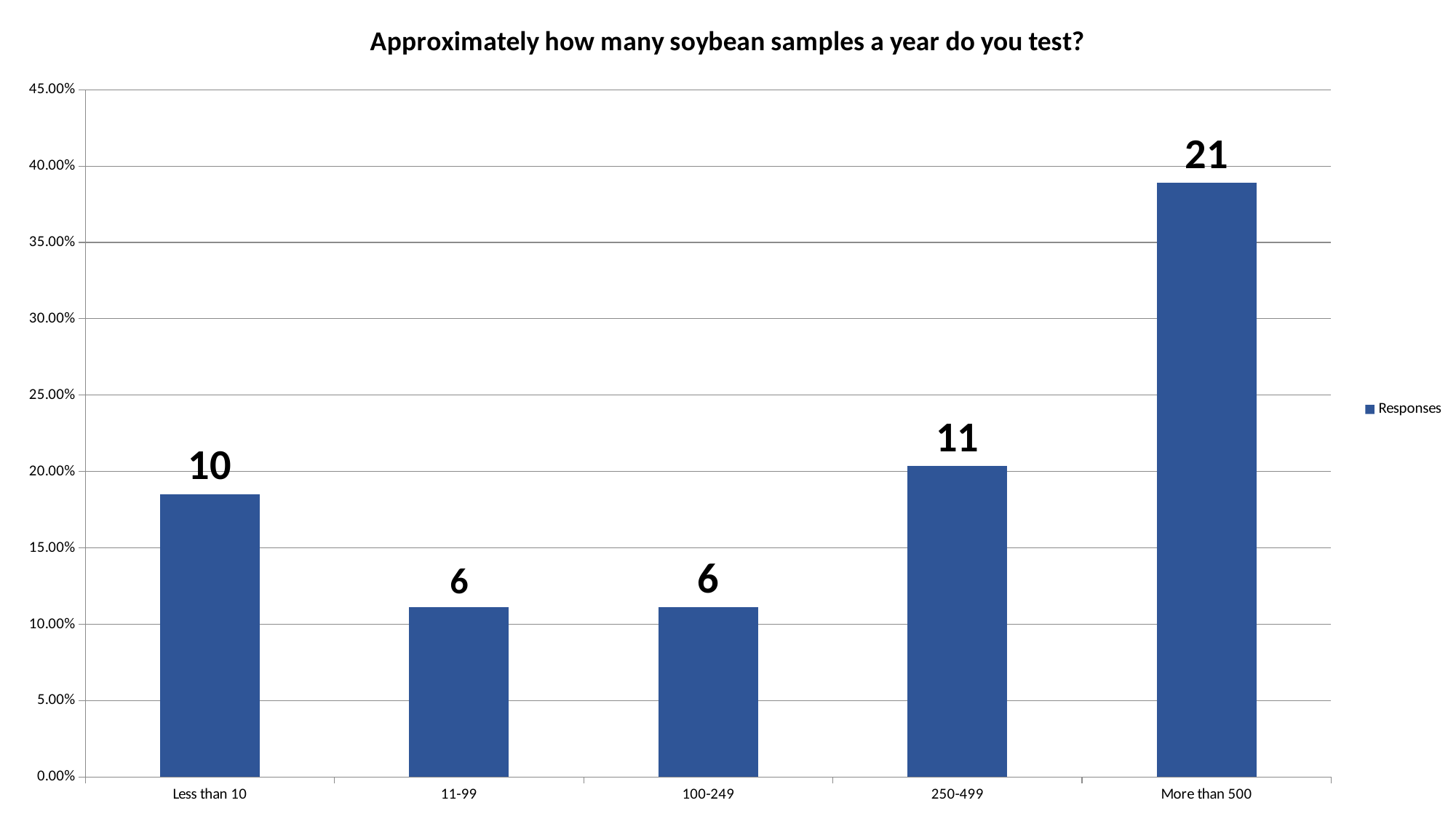
Is the value for 'More than 500' greater or less than 35.00%? greater What kind of chart is shown on the slide? Bar chart What is the data label shown for the 'More than 500' bar? 21 What is the title of the chart? Approximately how many soybean samples a year do you test? Which category has the highest bar? More than 500 What is the difference between the data labels for 'More than 500' and 'Less than 10'? 11 Is the value for '11-99' greater or less than 15.00%? less Which is larger, the bar for '250-499' or the bar for 'Less than 10'? 250-499 What is the data label shown for the 'Less than 10' bar? 10 How many categories are shown on the x axis? 5 How many series does the legend list? 1 What is the data label shown for the '250-499' bar? 11